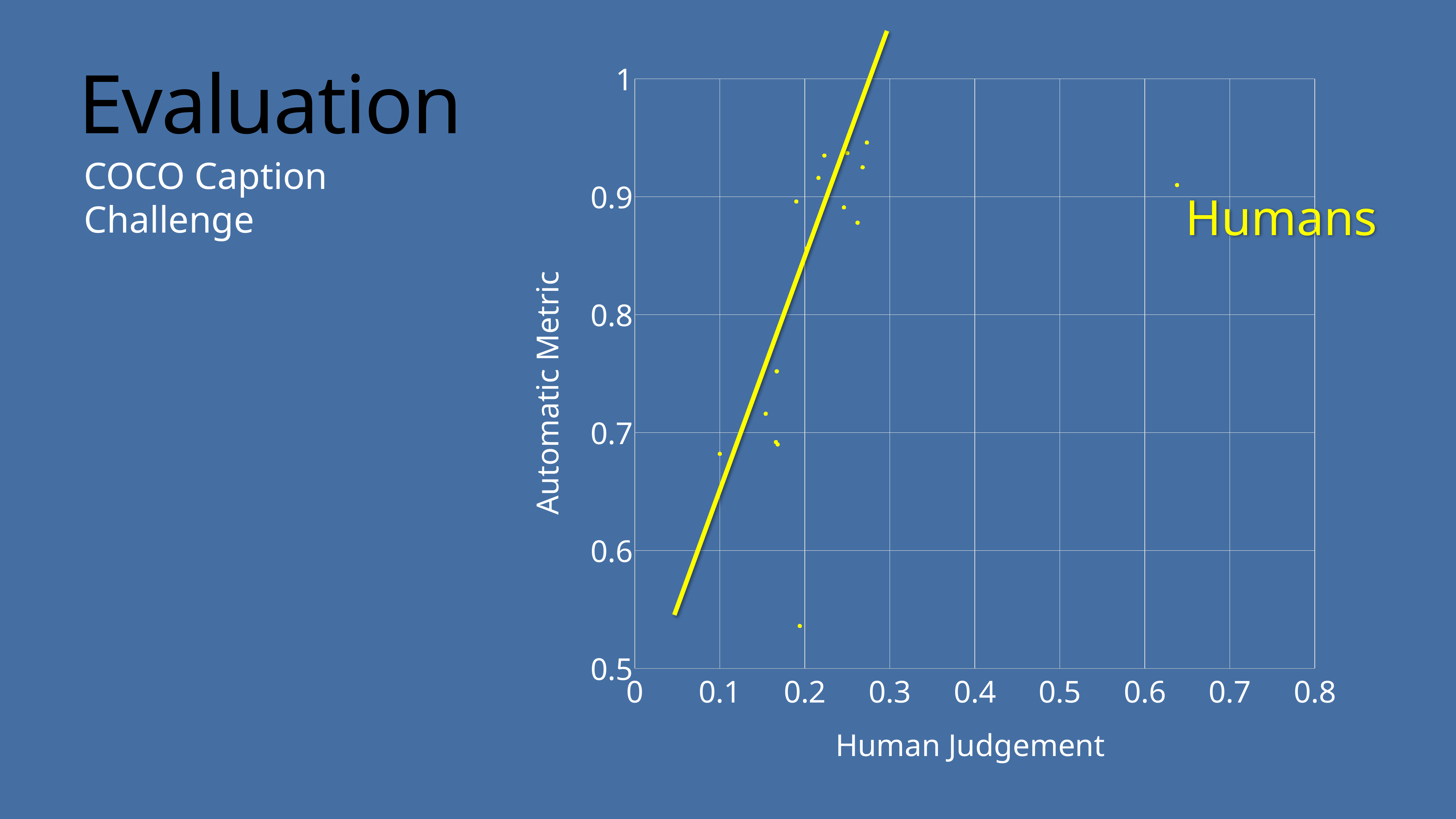
What is the label of the horizontal axis of the chart? Human Judgement Which point has the highest Human Judgement value? Humans What is the highest tick value shown on the Human Judgement axis? 0.8 What is the label of the vertical axis of the chart? Automatic Metric Is the Human Judgement value for the point labelled "Humans" greater or less than 0.5? greater Does the Automatic Metric generally rise or fall as Human Judgement increases along the trend line? rise Is the Automatic Metric value for the lowest point on the chart greater or less than 0.6? less Is the Human Judgement value for the leftmost point on the chart greater or less than 0.2? less What kind of chart is shown on the slide? Scatter plot Is the point labelled "Humans" the highest point on the Automatic Metric axis? No